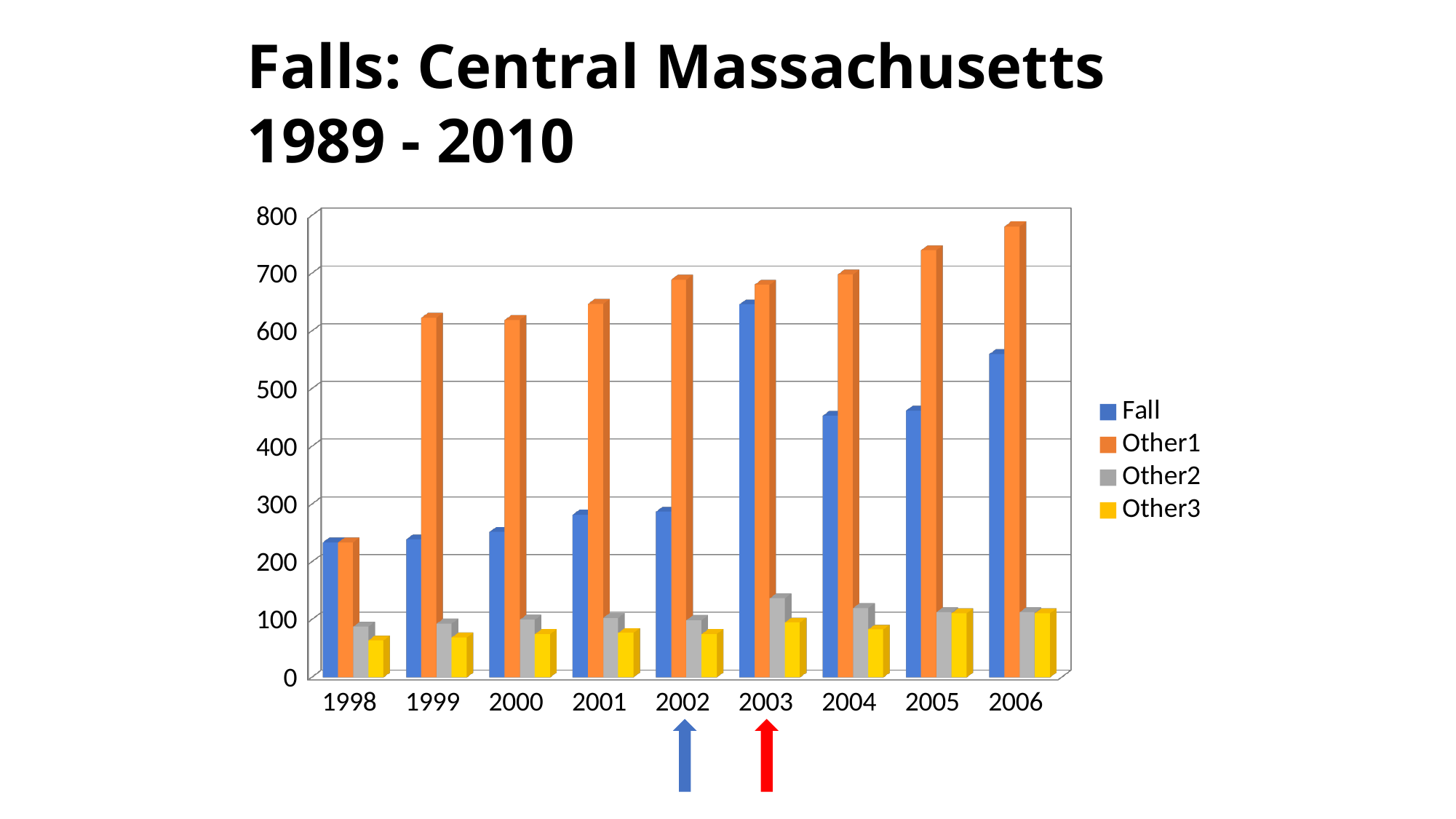
Is the Fall value for 2003 greater or less than 600? greater In which year is the Fall value highest? 2003 How many years are shown along the x axis? 9 In which year is the Other1 value lowest? 1998 What kind of chart is shown on the slide? Bar chart In which year is the Other1 value highest? 2006 In 2006, which is larger, the Fall value or the Other1 value? Other1 How many series does the legend list? 4 Is the Other1 value for 2006 greater or less than 700? greater Is the Other3 value for 1998 greater or less than 100? less Does the Other1 series generally rise or fall from 1998 to 2006? Rise